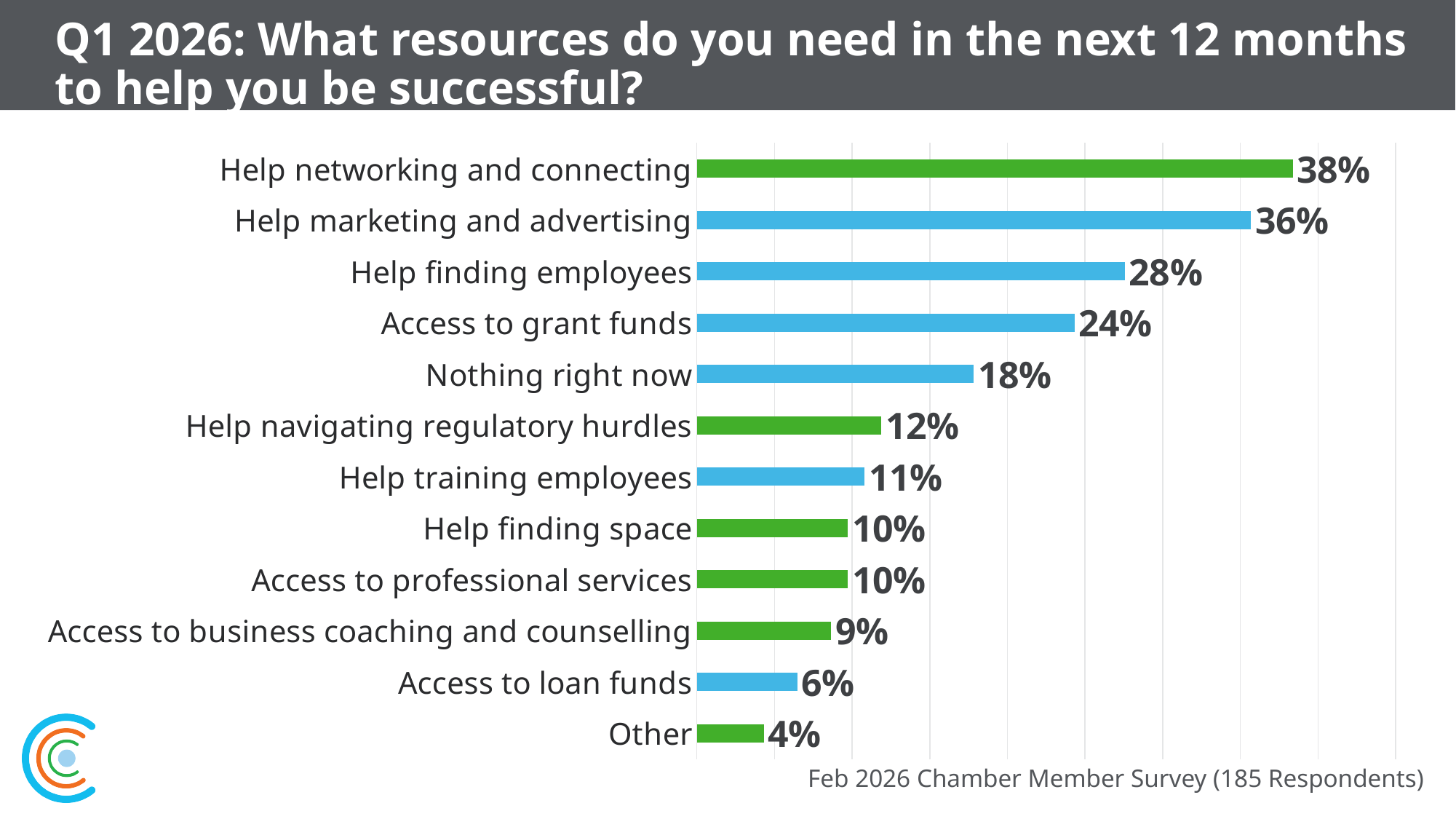
Which category has the lowest percentage? Other How many categories are shown in the chart? 12 Which resource has the highest percentage? Help networking and connecting What is the difference between Help marketing and advertising and Help finding employees? 8% What kind of chart is shown on the slide? Bar chart What is the difference between Help networking and connecting and Other? 34% What is the value for Access to loan funds? 6% Which is larger: Help navigating regulatory hurdles or Help training employees? Help navigating regulatory hurdles What percentage of respondents selected Nothing right now? 18% What percentage of respondents said they need help networking and connecting? 38% What is the value for Access to grant funds? 24% According to the note on the slide, how many respondents took part in the survey? 185